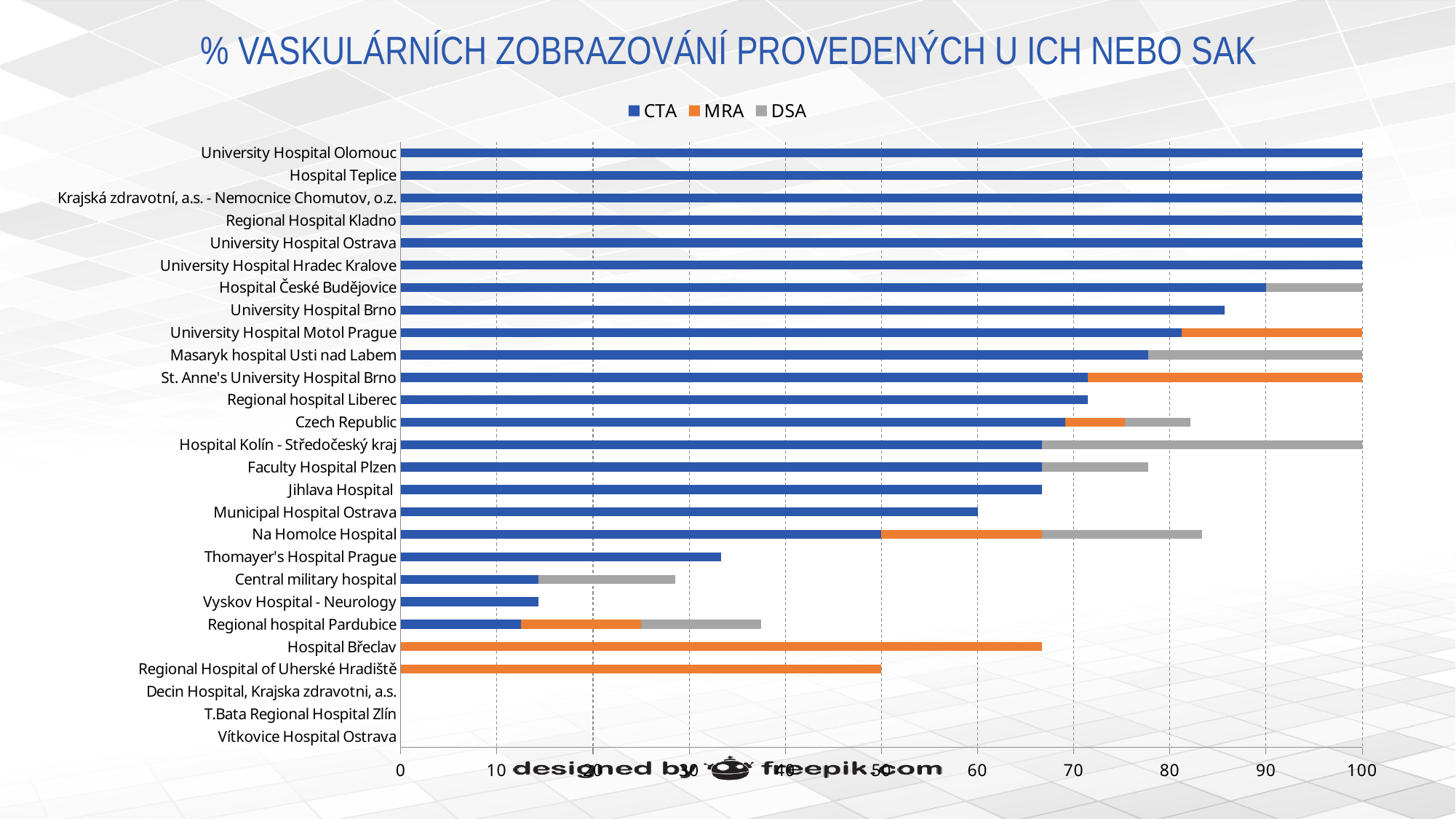
What is the CTA value for University Hospital Olomouc? 100 What is the MRA value for Regional Hospital of Uherské Hradiště? 50 How many hospitals/categories are listed on the vertical axis? 27 Is the CTA value for University Hospital Brno greater or less than 80? greater What is the title of the chart? % VASKULÁRNÍCH ZOBRAZOVÁNÍ PROVEDENÝCH U ICH NEBO SAK Is the CTA value for Central military hospital greater or less than 20? less How many series does the legend list? 3 Is the MRA value for Hospital Břeclav greater or less than 60? greater Which has the larger MRA value, Hospital Břeclav or Regional Hospital of Uherské Hradiště? Hospital Břeclav Which colour represents the DSA series in the legend? grey What kind of chart is shown on the slide? bar chart